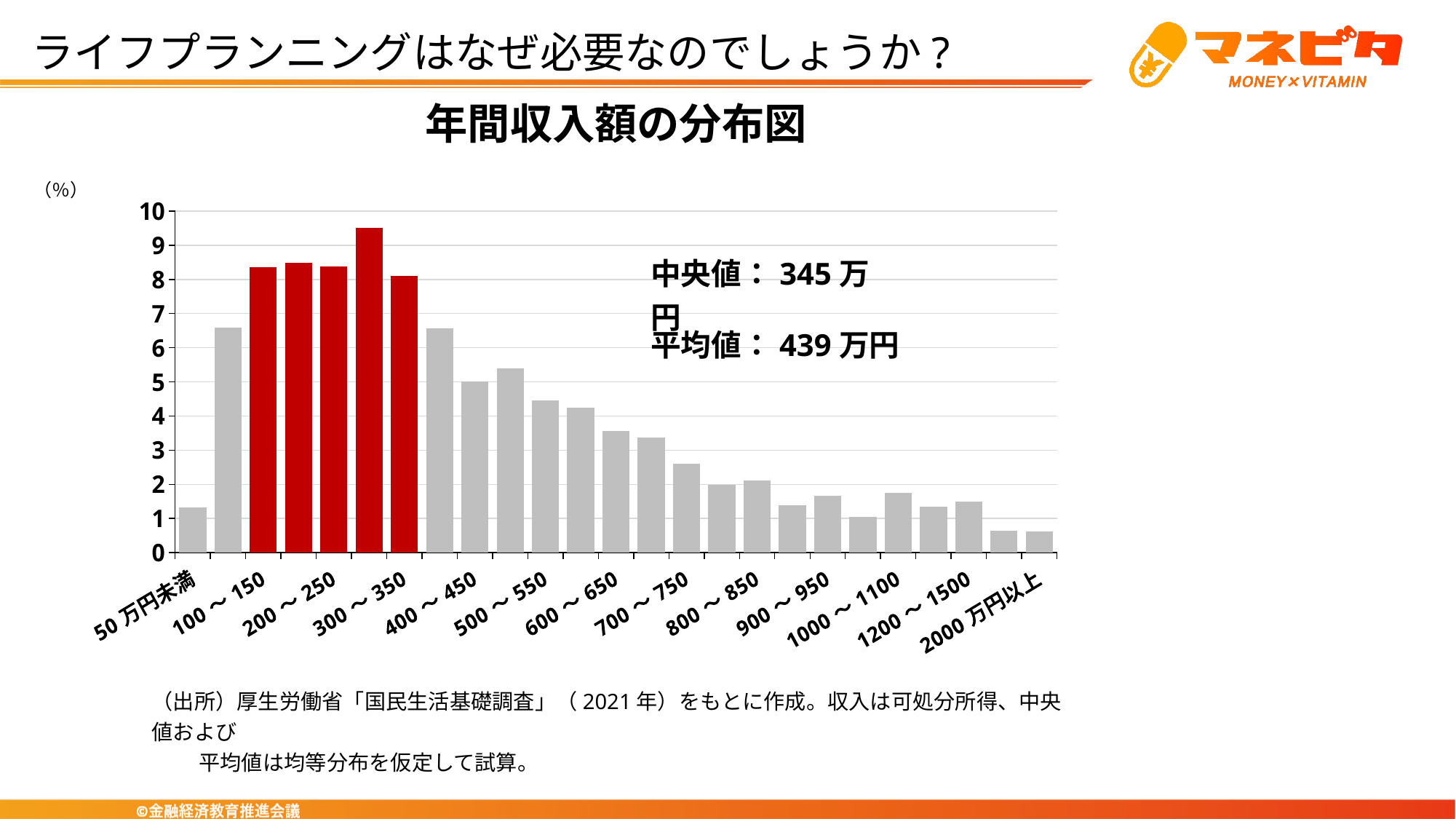
What median value (中央値) is stated on the chart? 345万円 Is the value for 700～750 greater or less than 4? less Is the value for 400～450 greater or less than 6? less Is the value for 100～150 greater or less than 8? greater Which is larger, the value for 100～150 or the value for 400～450? 100～150 What is the title of the chart? 年間収入額の分布図 What type of chart is shown on the slide? Bar chart Do the values generally rise or fall from 400～450 to 2000万円以上? fall Which is larger, the value for 600～650 or the value for 800～850? 600～650